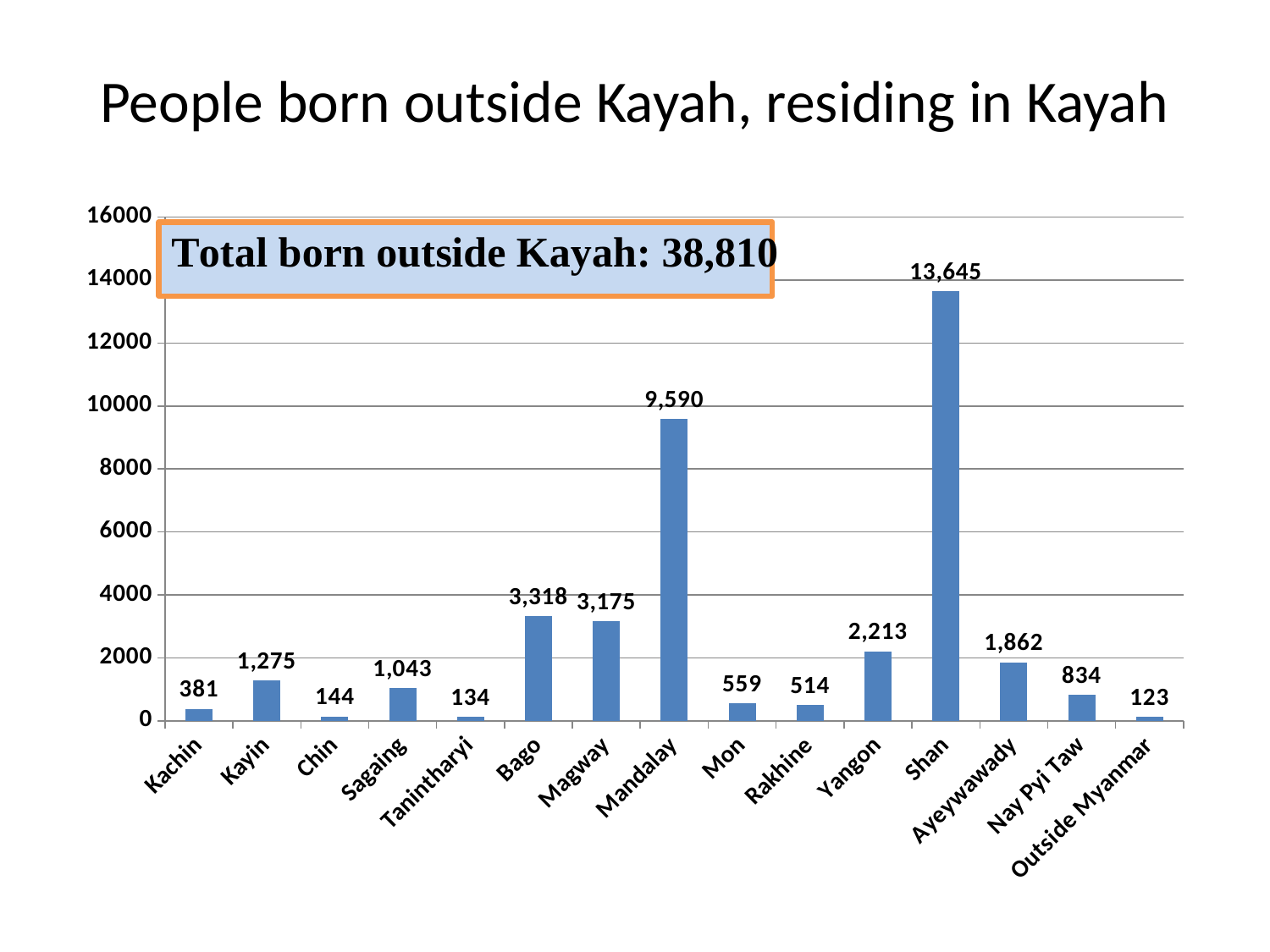
What is the value for Nay Pyi Taw? 834 Which category has the highest value? Shan What is the difference between the values for Bago and Magway? 143 What total is stated in the box on the chart? 38,810 What is the value for Shan? 13,645 What kind of chart is shown on the slide? bar chart Which is larger, the value for Yangon or the value for Ayeywawady? Yangon Is the value for Mandalay greater or less than 8000? greater What is the value for Mandalay? 9,590 How many categories are shown on the x axis? 15 Which category has the lowest value? Outside Myanmar What is the difference between the values for Shan and Mandalay? 4,055